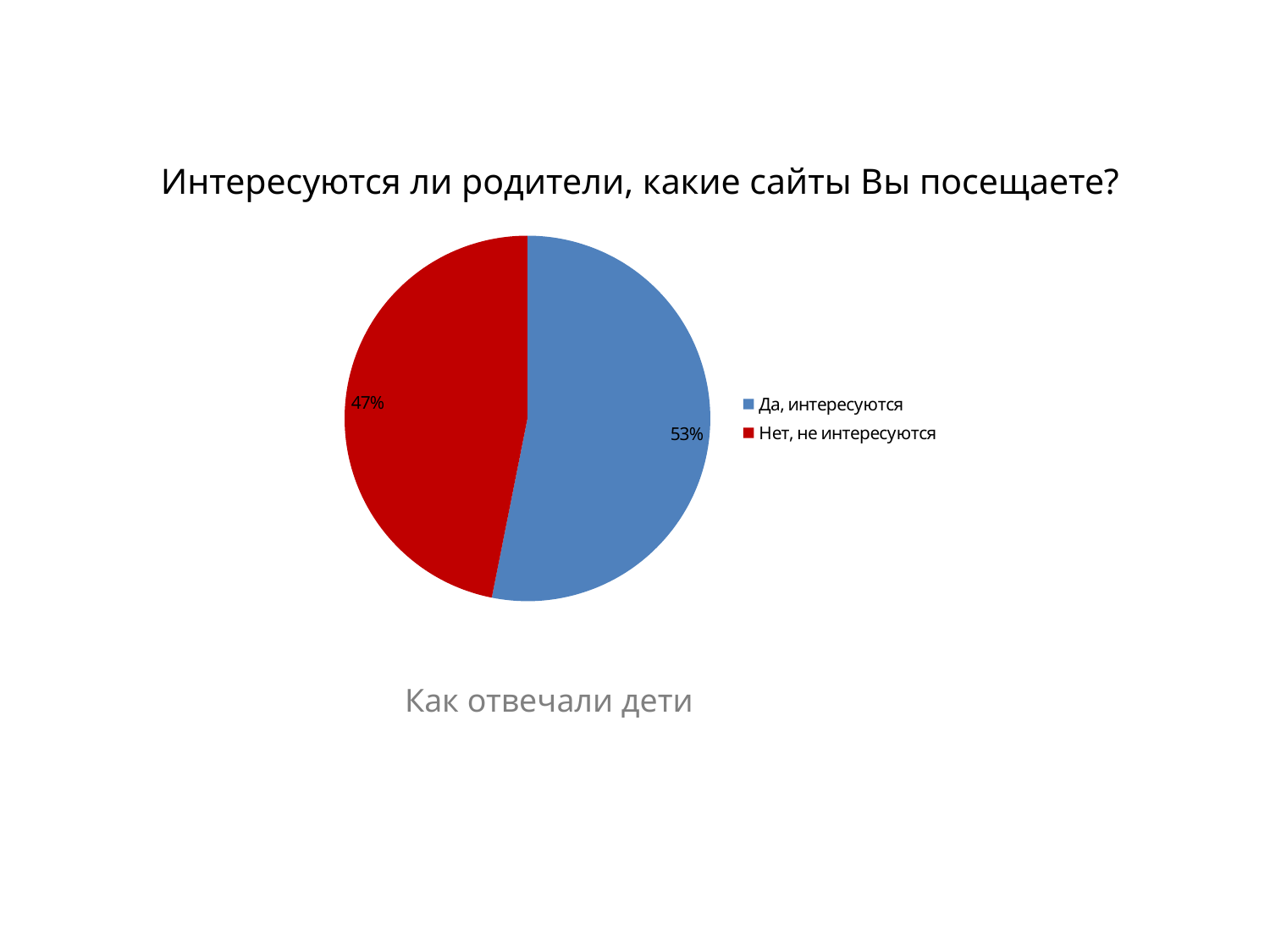
What colour is the "Нет, не интересуются" slice? red What share of the pie is labelled "Да, интересуются"? 53% Which slice is the largest? Да, интересуются Which is larger: the "Да, интересуются" slice or the "Нет, не интересуются" slice? Да, интересуются How many slices does the pie chart have? 2 Which slice is the smallest? Нет, не интересуются What is the title of the chart? Интересуются ли родители, какие сайты Вы посещаете? What share of the pie is labelled "Нет, не интересуются"? 47% How many entries does the legend list? 2 What kind of chart is shown on the slide? pie chart What is the difference between the "Да, интересуются" and "Нет, не интересуются" shares? 6%